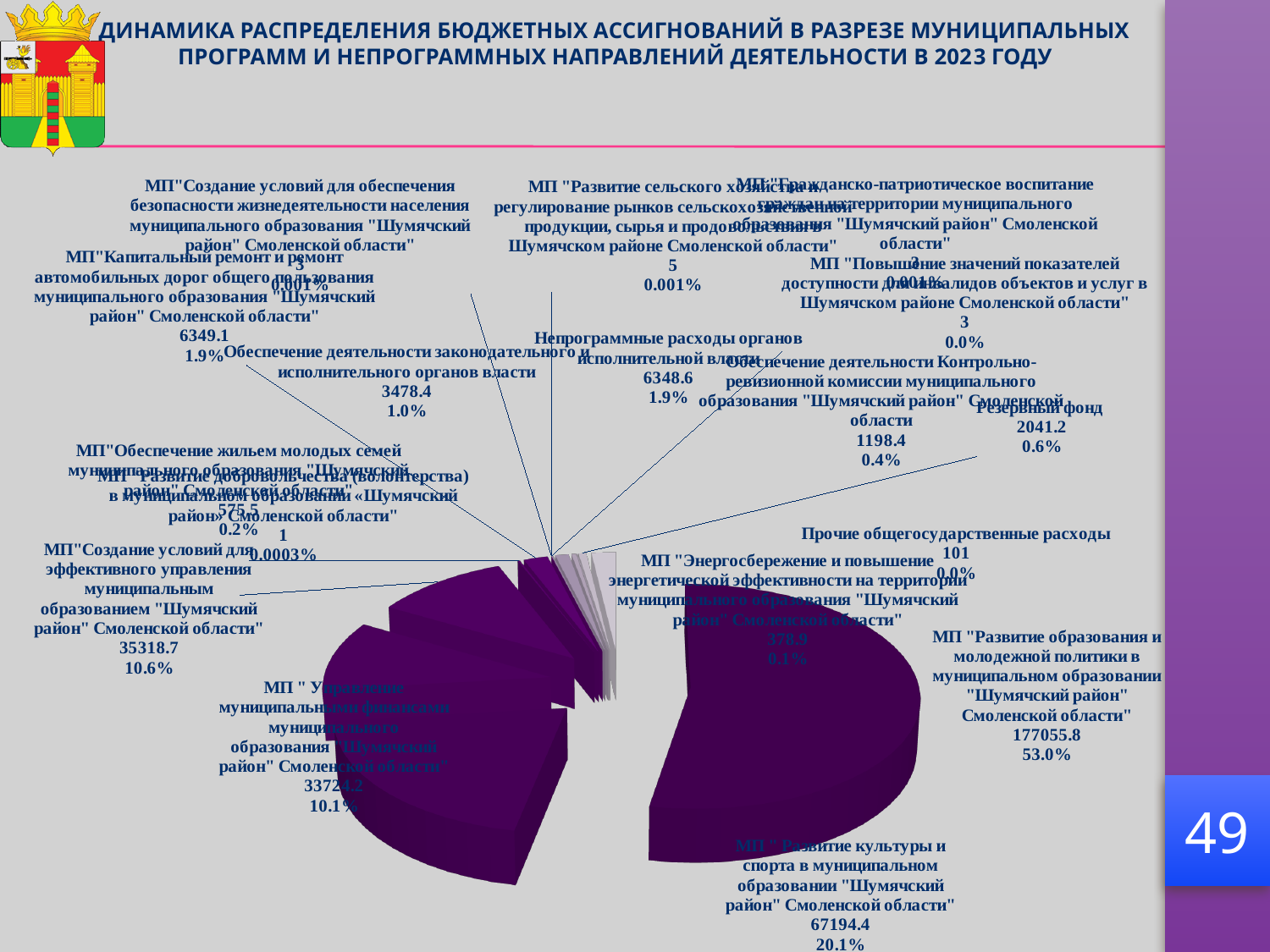
What share of the pie does МП "Развитие образования и молодежной политики" account for? 53.0% What kind of chart is shown on the slide? pie chart What is the difference between the values for МП "Развитие образования и молодежной политики" and МП "Развитие культуры и спорта"? 109861.4 Which category has the largest share of the pie? МП "Развитие образования и молодежной политики в муниципальном образовании "Шумячский район" Смоленской области" What value is shown for МП "Развитие образования и молодежной политики в муниципальном образовании "Шумячский район" Смоленской области"? 177055.8 What percentage is shown for Обеспечение деятельности Контрольно-ревизионной комиссии муниципального образования "Шумячский район" Смоленской области? 0.4% What percentage is shown for МП "Управление муниципальными финансами"? 10.1% Which is larger: the value for МП "Развитие культуры и спорта" or for МП "Создание условий для эффективного управления муниципальным образованием"? МП "Развитие культуры и спорта" What value is shown for Резервный фонд? 2041.2 What value is shown for МП "Развитие культуры и спорта в муниципальном образовании "Шумячский район" Смоленской области"? 67194.4 What value is shown for Непрограммные расходы органов исполнительной власти? 6348.6 What value is shown for Прочие общегосударственные расходы? 101